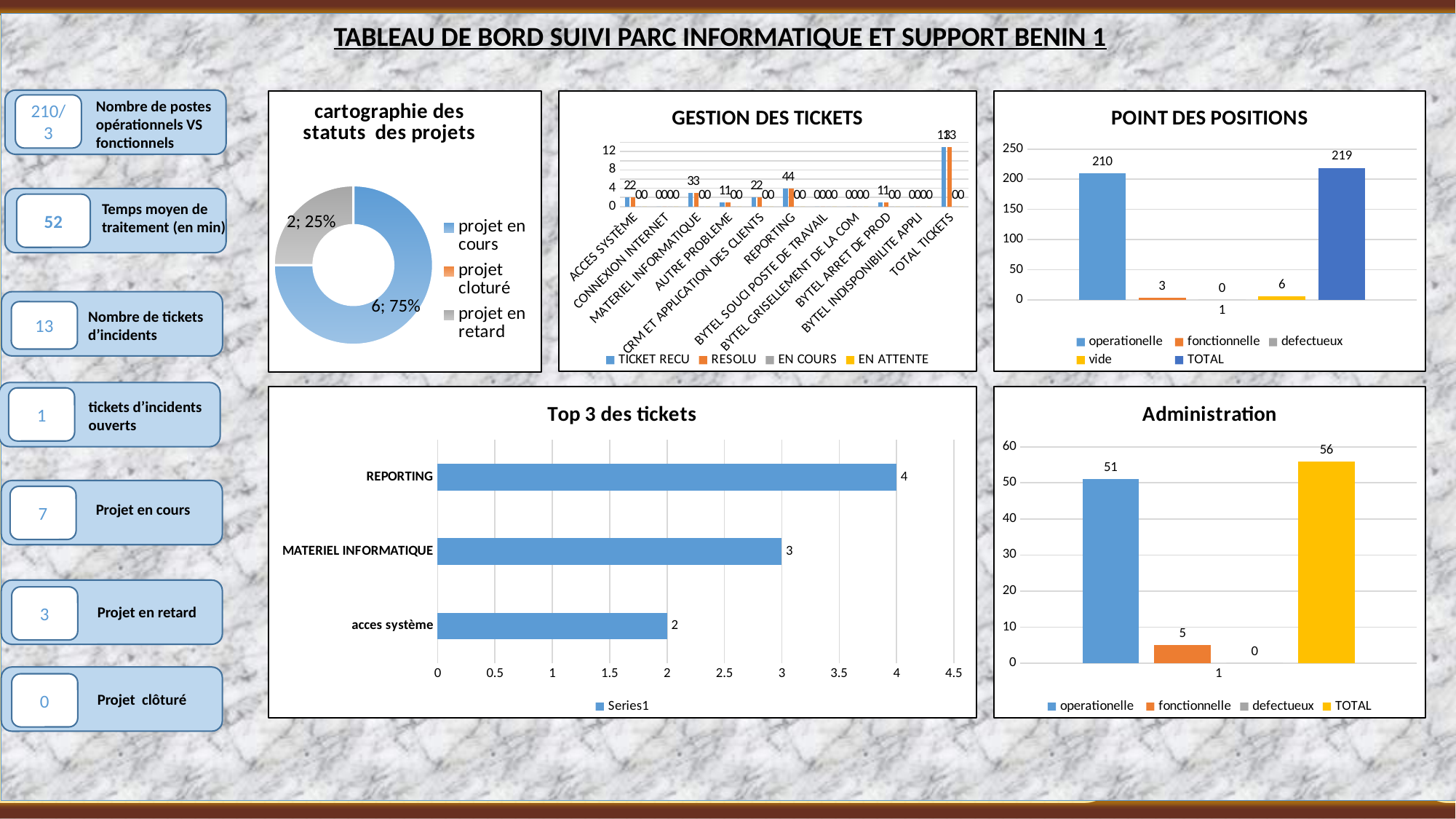
In the 'Top 3 des tickets' chart, what is the value for MATERIEL INFORMATIQUE? 3 In the 'POINT DES POSITIONS' chart, what is the value for TOTAL? 219 How many series does the legend of the 'POINT DES POSITIONS' chart list? 5 In the 'Administration' chart, which is larger, operationelle or TOTAL? TOTAL In the 'cartographie des statuts des projets' chart, what share of the donut is 'projet en cours'? 75% In the 'POINT DES POSITIONS' chart, what is the value for operationelle? 210 In the 'Top 3 des tickets' chart, which category has the lowest value? acces système In the 'POINT DES POSITIONS' chart, what is the difference between the TOTAL bar and the operationelle bar? 9 In the 'Administration' chart, what is the value for fonctionnelle? 5 What kind of chart is 'Top 3 des tickets'? Bar chart In the 'Top 3 des tickets' chart, which category has the highest value? REPORTING In the 'Administration' chart, is the value for operationelle greater or less than 40? greater